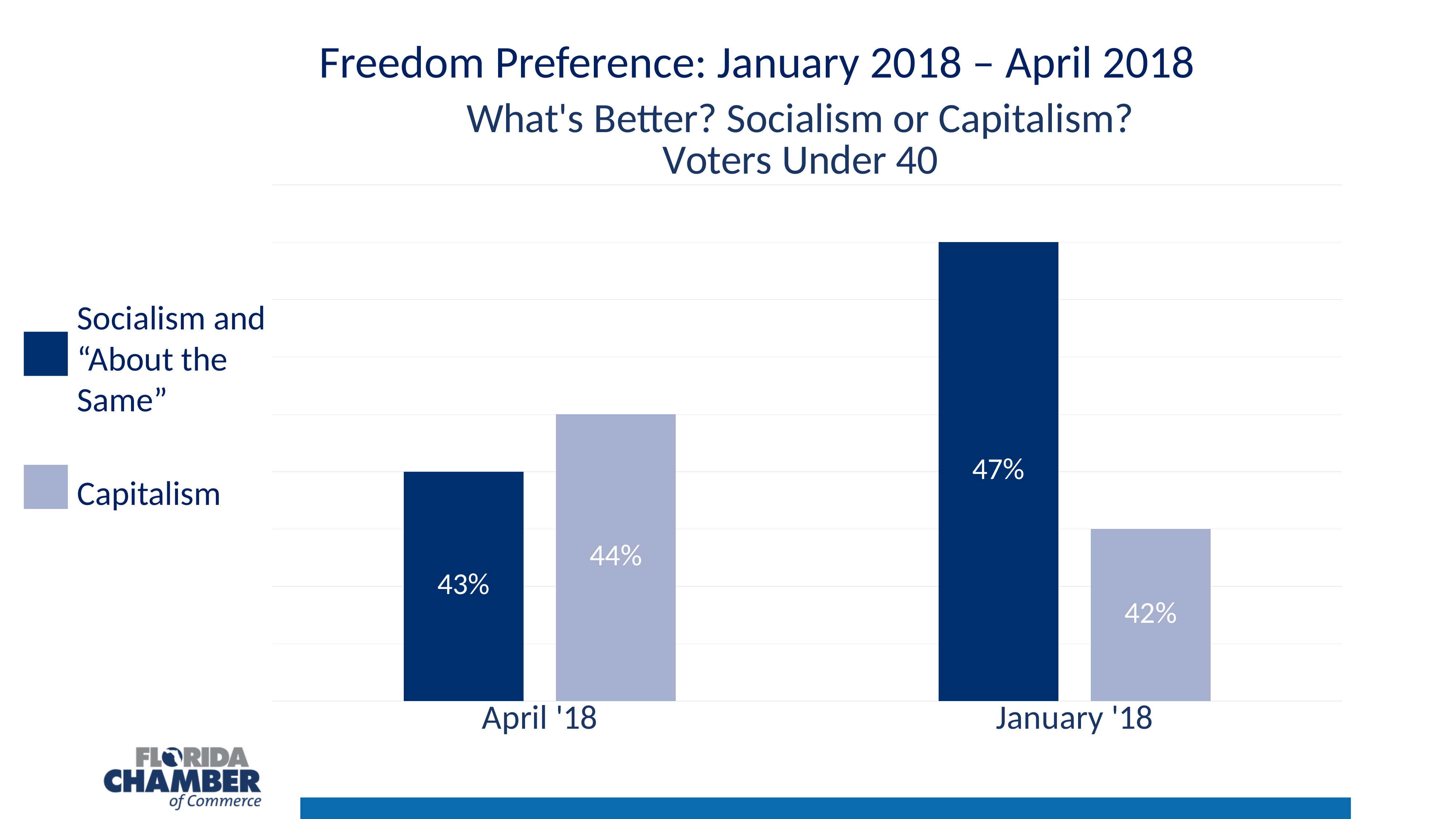
What kind of chart is shown on the slide? Bar chart How many time periods are shown on the x axis? 2 What is the value for Socialism and "About the Same" in April '18? 43% What is the difference between Socialism and "About the Same" and Capitalism in January '18? 5% What is the value for Capitalism in April '18? 44% What is the value for Socialism and "About the Same" in January '18? 47% Which bar has the highest value on the chart? Socialism and "About the Same" in January '18 What is the difference between the Socialism and "About the Same" values in January '18 and April '18? 4% Which bar has the lowest value on the chart? Capitalism in January '18 How many series does the legend list? 2 In April '18, which is larger: Socialism and "About the Same" or Capitalism? Capitalism What is the value for Capitalism in January '18? 42%